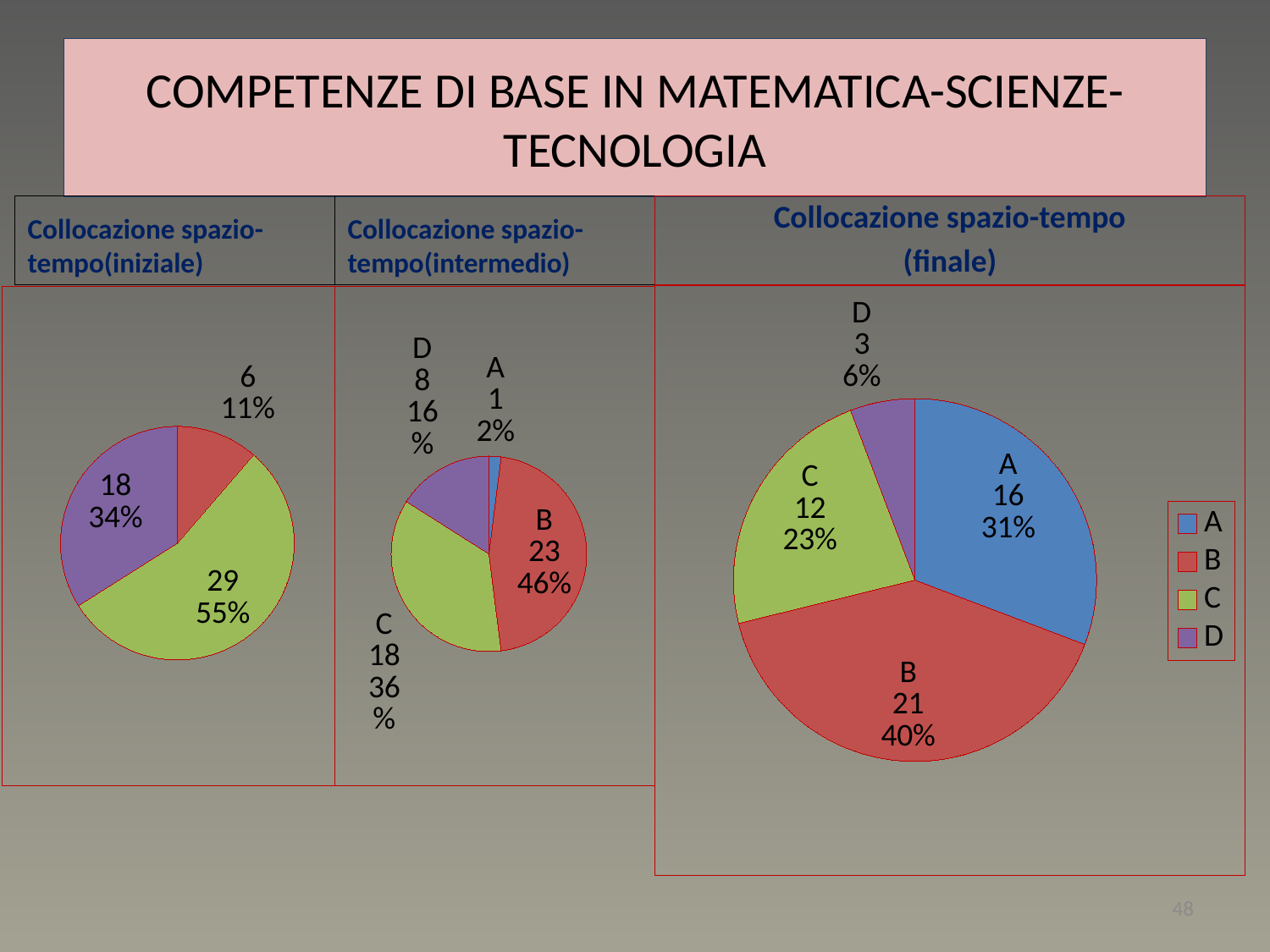
In the 'Collocazione spazio-tempo(intermedio)' chart, which is larger, the value for C or the value for D? C In the 'Collocazione spazio-tempo(iniziale)' chart, what percentage is shown for the green slice? 55% In the 'Collocazione spazio-tempo(intermedio)' chart, what share of the pie does category D have? 16% In the 'Collocazione spazio-tempo (finale)' chart, what is the difference between the values for B and A? 5 What kind of chart is used for 'Collocazione spazio-tempo (finale)'? pie chart How many slices does the 'Collocazione spazio-tempo(iniziale)' chart have? 3 In the 'Collocazione spazio-tempo (finale)' chart, what share of the pie does category C have? 23% In the 'Collocazione spazio-tempo (finale)' chart, which category has the smallest slice? D In the 'Collocazione spazio-tempo (finale)' chart, what value is shown for category B? 21 In the 'Collocazione spazio-tempo(intermedio)' chart, what value is shown for category A? 1 In the 'Collocazione spazio-tempo(intermedio)' chart, which category has the largest slice? B In the 'Collocazione spazio-tempo (finale)' chart, which category has the largest slice? B